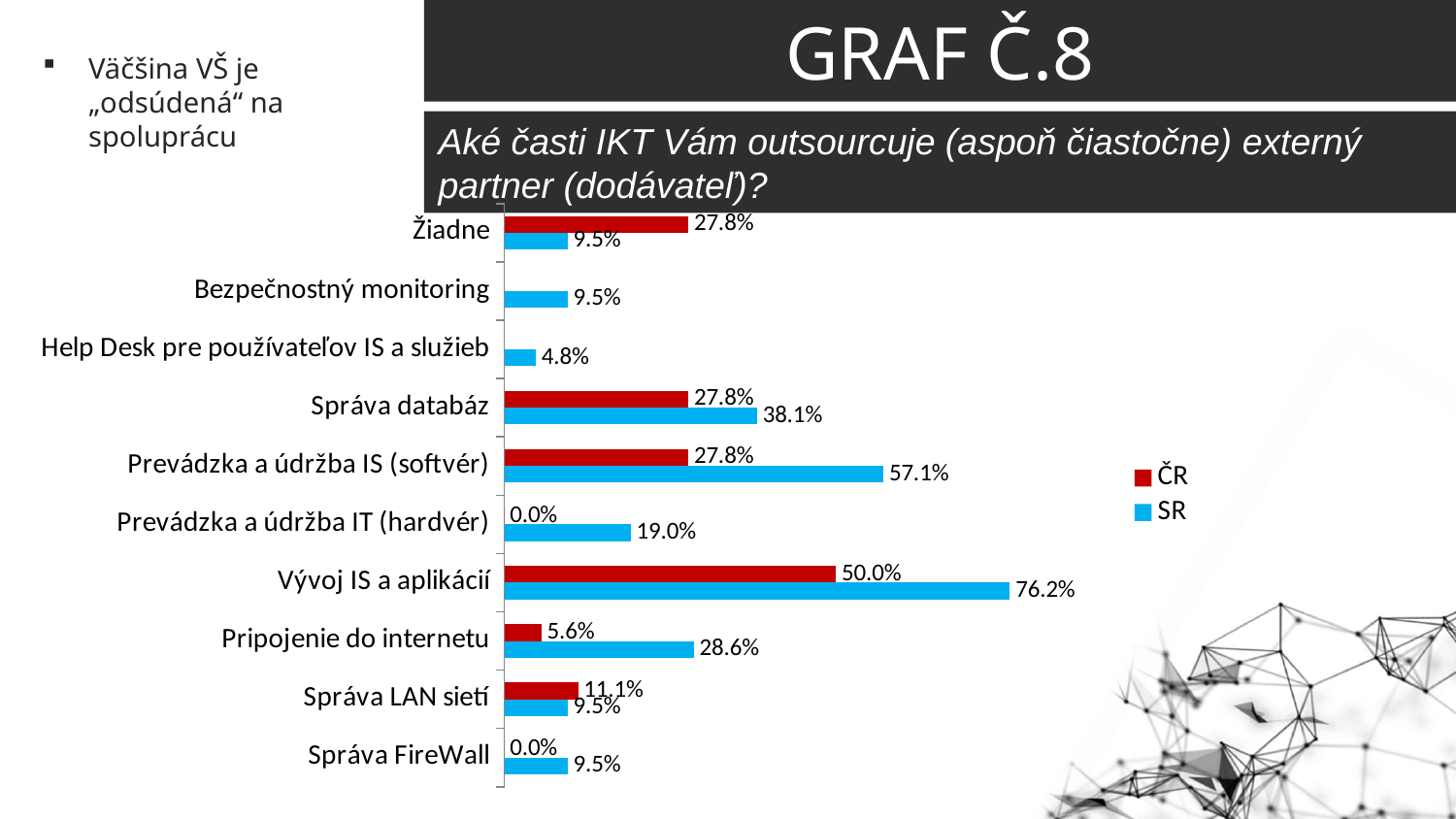
What is the ČR value for Vývoj IS a aplikácií? 50.0% How many series does the legend list? 2 What type of chart is shown on the slide? bar chart What is the SR value for Prevádzka a údržba IS (softvér)? 57.1% What is the ČR value for Správa FireWall? 0.0% Which is larger for Správa LAN sietí, the ČR value or the SR value? ČR Which category has the highest SR value? Vývoj IS a aplikácií Which category has the highest ČR value? Vývoj IS a aplikácií How many categories are shown on the chart? 10 What is the difference between the SR and ČR values for Vývoj IS a aplikácií? 26.2% What is the ČR value for Pripojenie do internetu? 5.6% What is the SR value for Vývoj IS a aplikácií? 76.2%